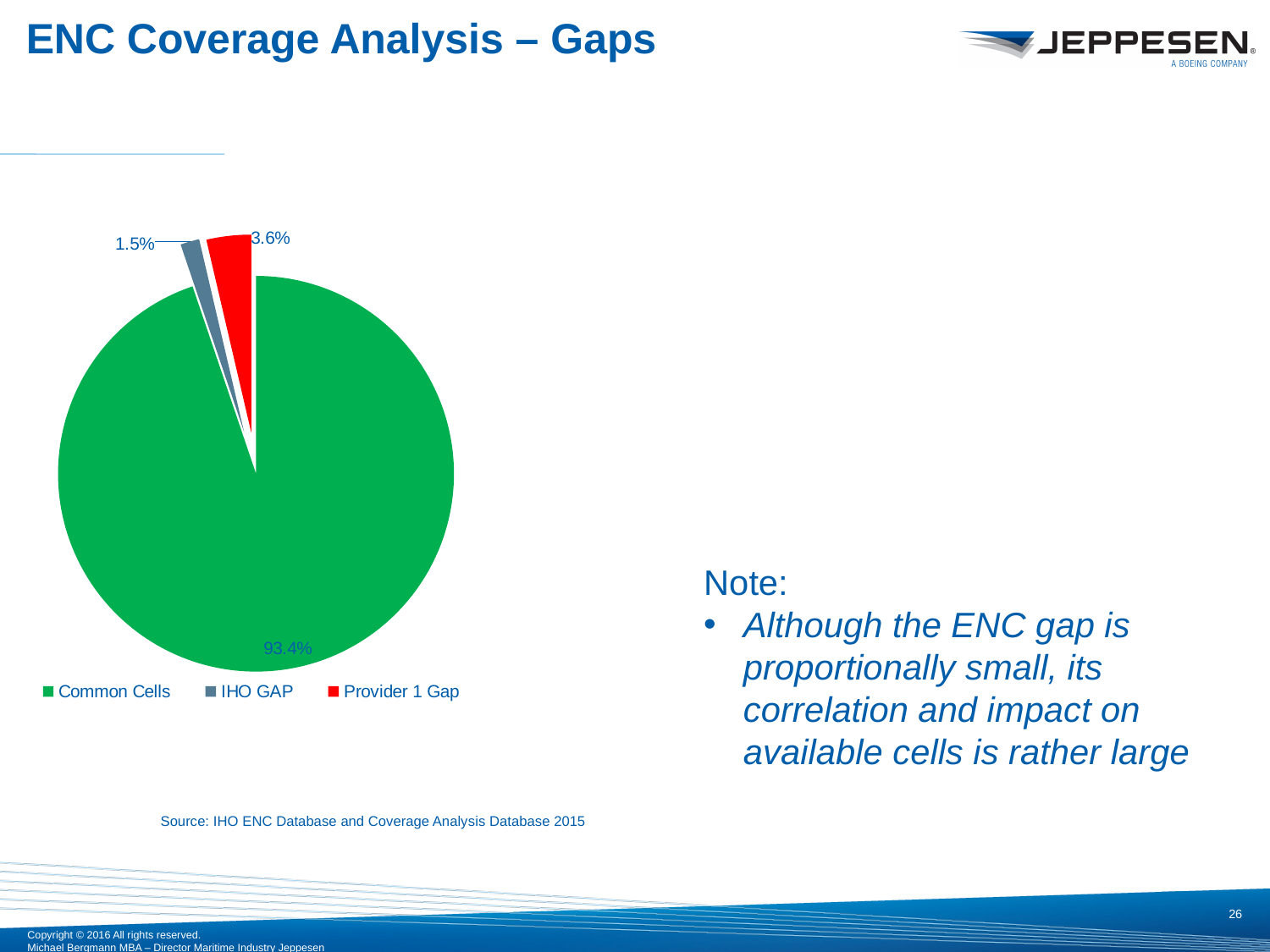
How many entries does the legend list? 3 What type of chart is shown on the slide? Pie chart Which category has the smallest slice of the pie? IHO GAP What colour is the Provider 1 Gap slice in the pie chart? Red What is the difference in percentage points between the Provider 1 Gap slice and the IHO GAP slice? 2.1% Which is larger, the Provider 1 Gap slice or the IHO GAP slice? Provider 1 Gap What share of the pie does Common Cells represent? 93.4% How many slices does the pie chart have? 3 Which category has the largest slice of the pie? Common Cells What share of the pie does Provider 1 Gap represent? 3.6% What is the difference in percentage points between the Common Cells slice and the Provider 1 Gap slice? 89.8% What share of the pie does IHO GAP represent? 1.5%